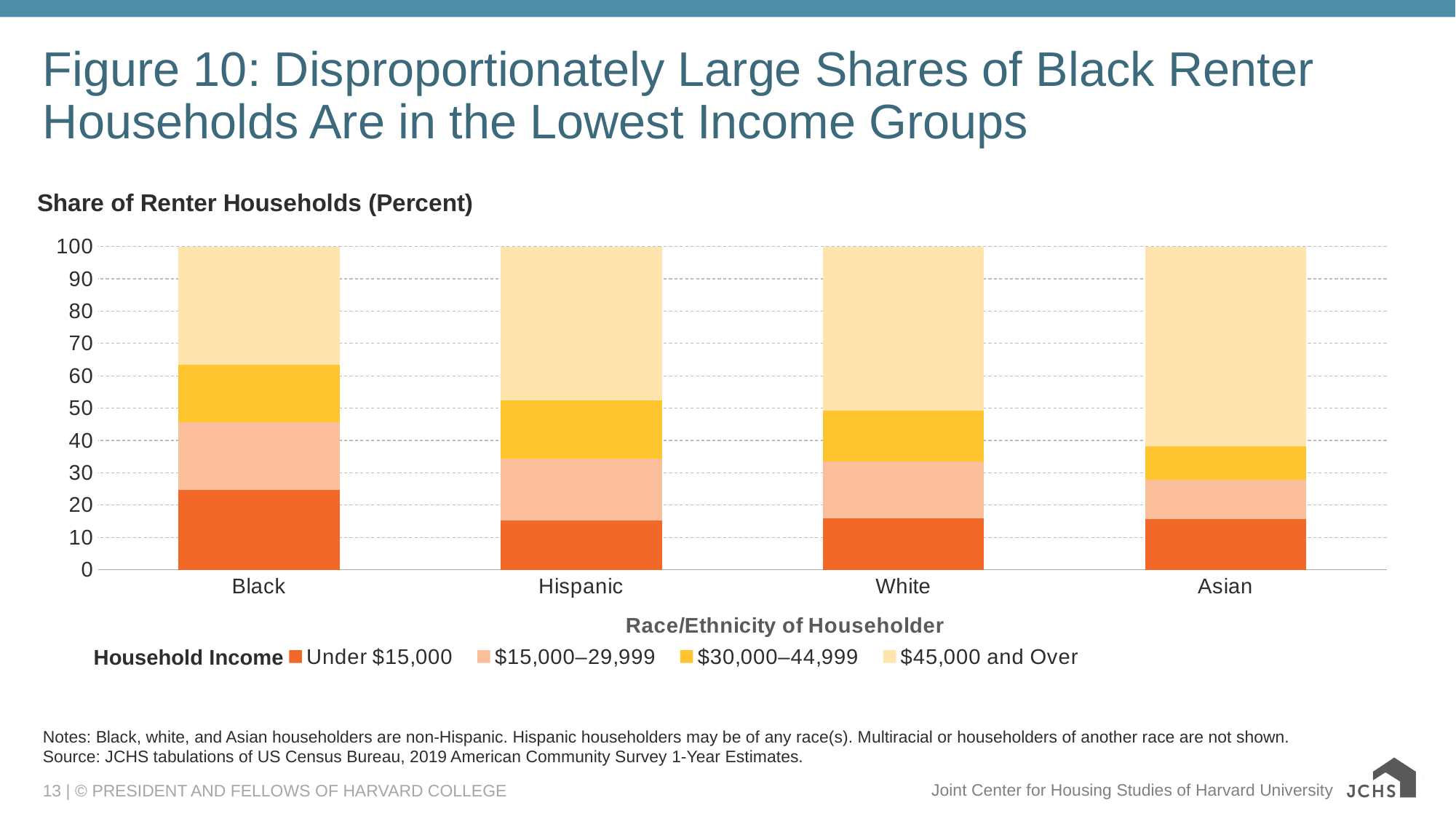
What is the total of the stacked bar for White renter households? 100 Is the share of Black renter households with income under $15,000 greater or less than 20? greater Which race/ethnicity group has the largest share of renter households with income of $45,000 and over? Asian How many race/ethnicity categories are shown on the x axis? 4 What is the label of the x axis? Race/Ethnicity of Householder Which race/ethnicity group has the largest share of renter households with income under $15,000? Black How many household income series does the legend list? 4 Which is larger: the share of Black or Asian renter households with income of $30,000–44,999? Black Which race/ethnicity group has the smallest share of renter households with income of $30,000–44,999? Asian Which race/ethnicity group has the smallest share of renter households with income of $45,000 and over? Black Is the share of Hispanic renter households with income under $15,000 greater or less than 20? less What kind of chart is shown on the slide? Stacked bar chart